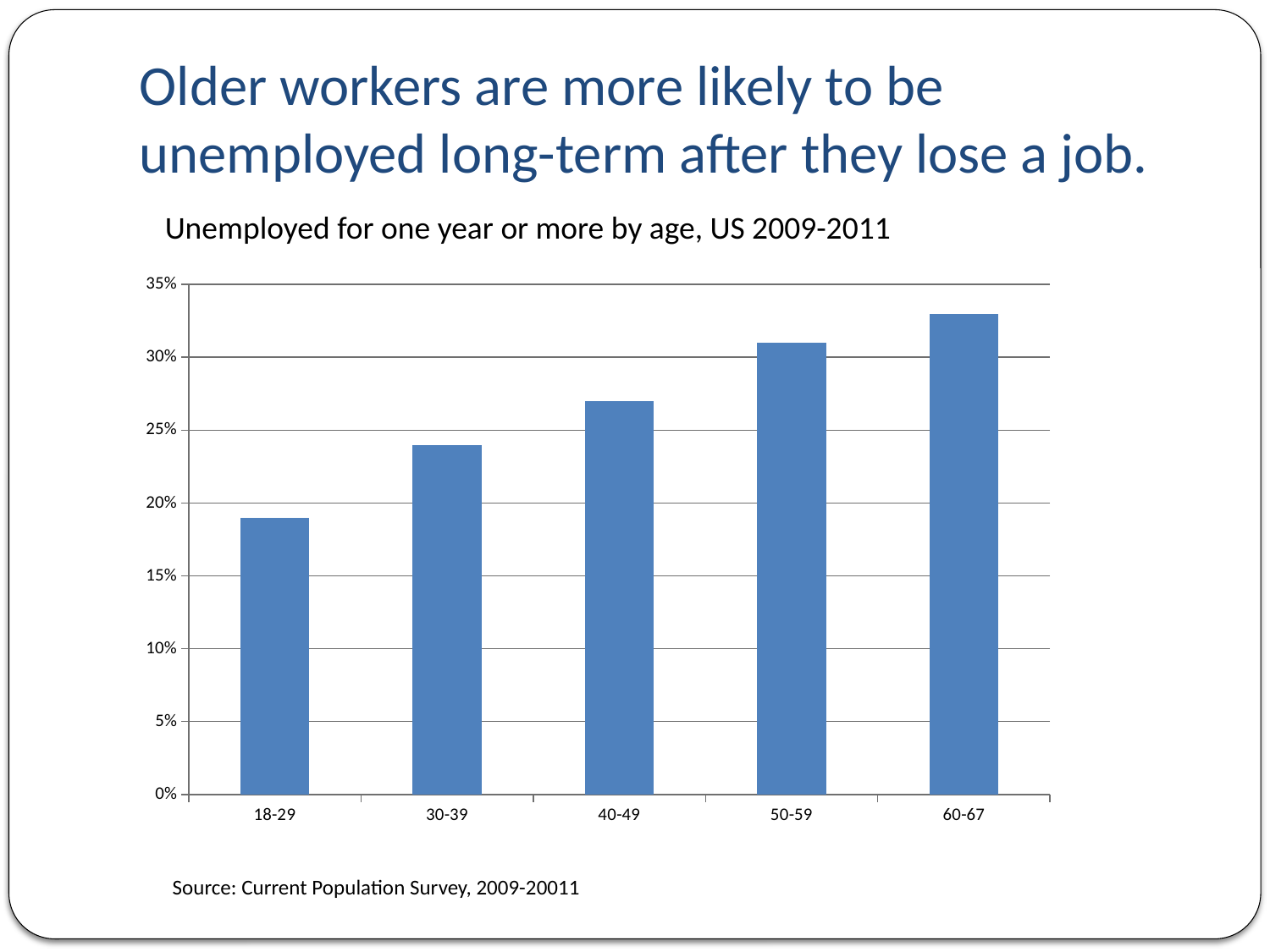
Is the value for the 40-49 age group greater or less than 25%? greater Which age group has a larger value, 30-39 or 50-59? 50-59 Do the values rise or fall as age increases along the x axis? rise Which age group has the highest share unemployed for one year or more? 60-67 What is the title of the chart? Unemployed for one year or more by age, US 2009-2011 Is the value for the 50-59 age group greater or less than 30%? greater Is the value for the 60-67 age group greater or less than 35%? less What kind of chart is shown on the slide? bar chart Which age group has the lowest share unemployed for one year or more? 18-29 How many age groups are shown on the x axis of the chart? 5